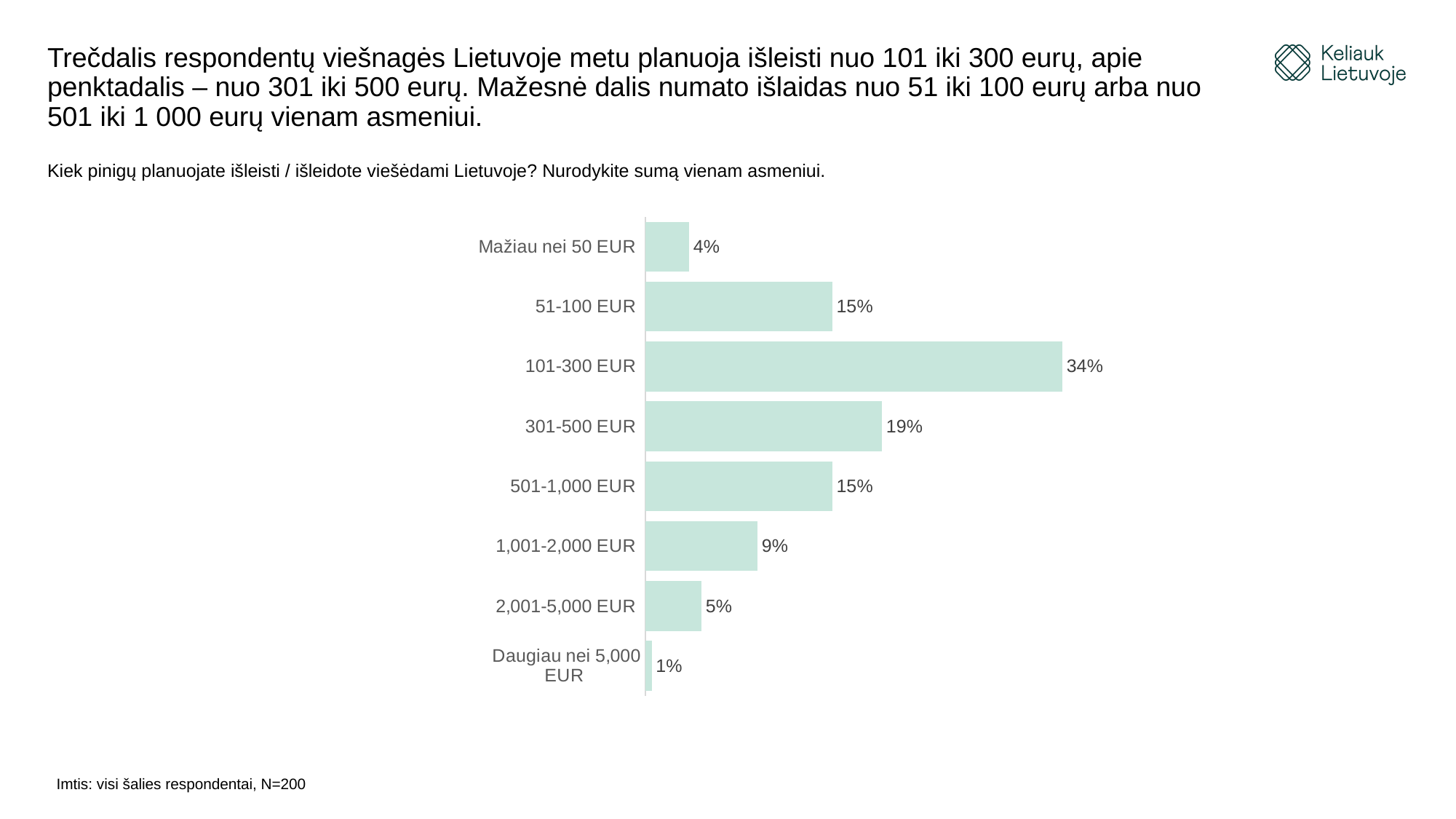
Which category has the highest value? 101-300 EUR What is the value for Mažiau nei 50 EUR? 4% Which category has the lowest value? Daugiau nei 5,000 EUR What is the sample size stated below the chart? N=200 What kind of chart is shown on the slide? bar chart What is the difference between the values for 1,001-2,000 EUR and 2,001-5,000 EUR? 4% Which is larger, the value for 51-100 EUR or the value for 1,001-2,000 EUR? 51-100 EUR How many categories are shown in the chart? 8 What is the value for 301-500 EUR? 19% What is the value for 101-300 EUR? 34% What is the difference between the values for 101-300 EUR and 301-500 EUR? 15% What is the value for 2,001-5,000 EUR? 5%